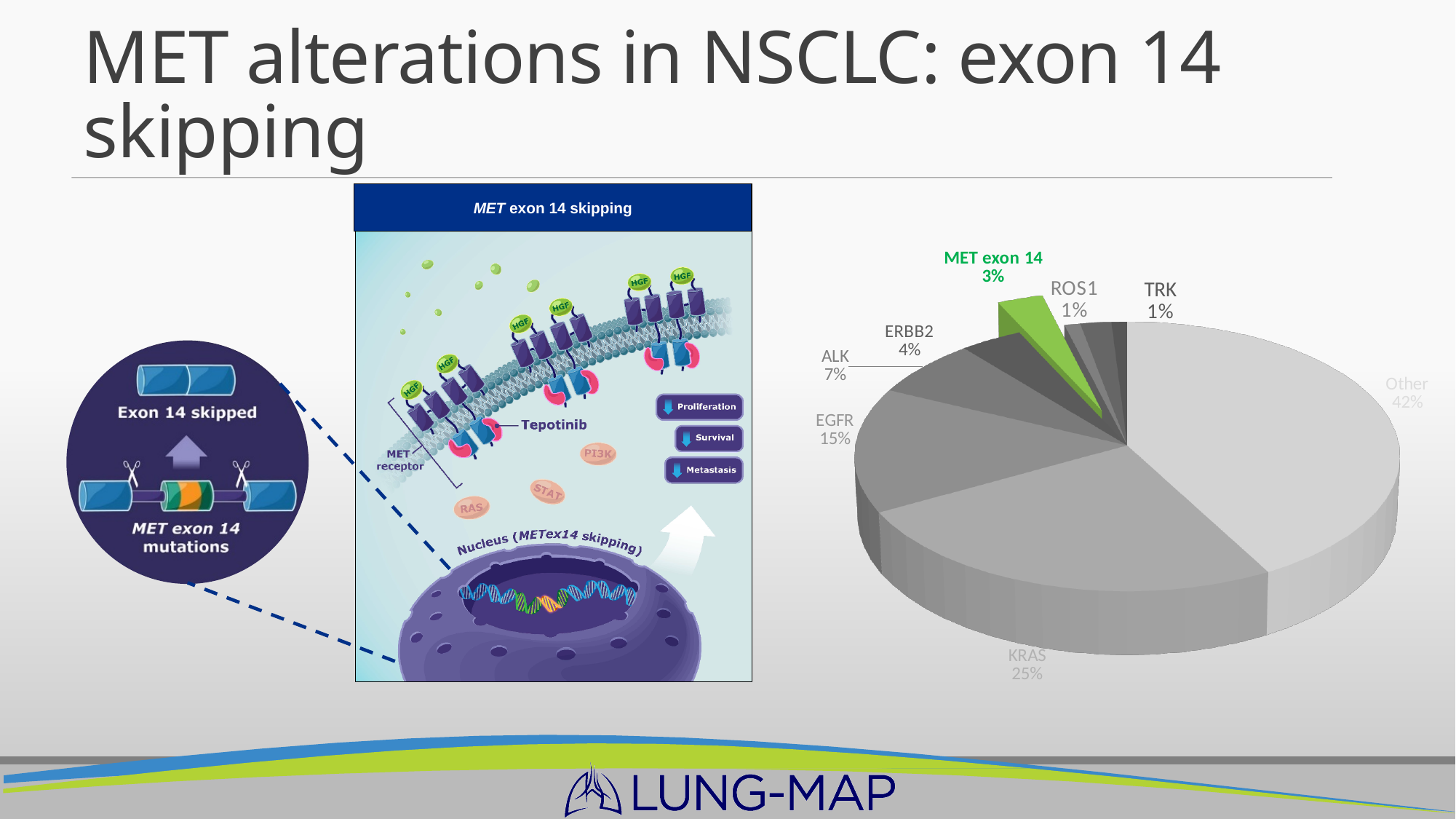
What percentage of the pie chart is labelled MET exon 14? 3% Which slice of the pie chart is highlighted in green? MET exon 14 What share of the pie chart does KRAS account for? 25% Which categories share the smallest value in the pie chart? ROS1 and TRK What is the combined percentage of ROS1 and TRK in the pie chart? 2% What kind of chart is shown on the right side of the slide? pie chart What percentage is shown for ALK in the pie chart? 7% How many slices does the pie chart have? 9 What is the difference in percentage points between KRAS and EGFR in the pie chart? 10 Which is larger in the pie chart, ALK or ERBB2? ALK What is the value shown for EGFR in the pie chart? 15% Which category has the largest slice in the pie chart? Other